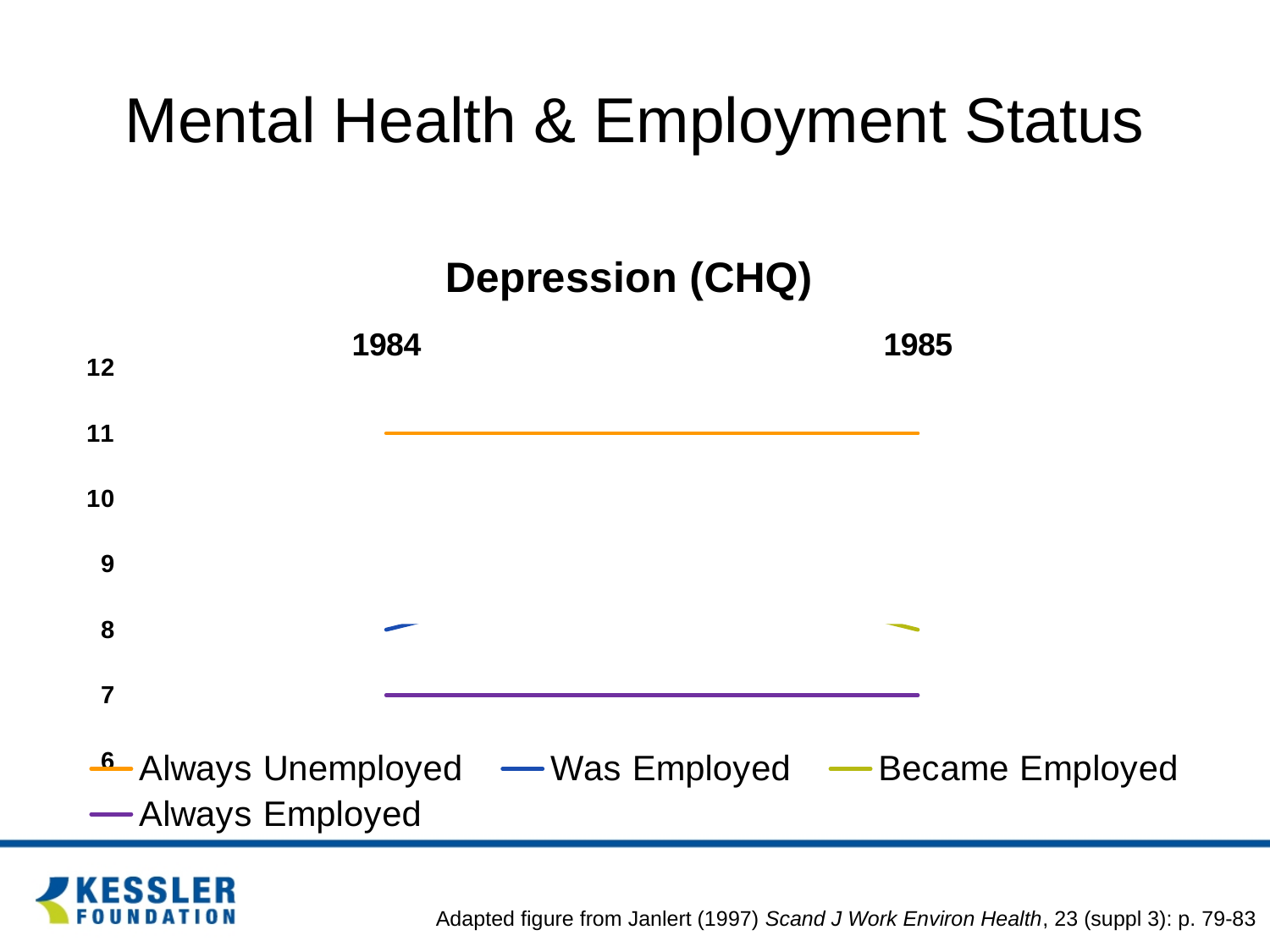
What depression score does the Always Employed line sit at? 7 What is the title of the chart? Depression (CHQ) How many series does the legend list? 4 Is the depression score for Always Employed greater or less than 8? less Is the depression score for Always Unemployed greater or less than 10? greater Which series has the lowest depression score? Always Employed Which series has a higher depression score, Always Unemployed or Always Employed? Always Unemployed Which series has the highest depression score? Always Unemployed How many years are shown on the x axis? 2 What depression score does the Always Unemployed line sit at? 11 What kind of chart is shown on the slide? line chart Does the Always Unemployed line rise, fall or stay flat from 1984 to 1985? stays flat